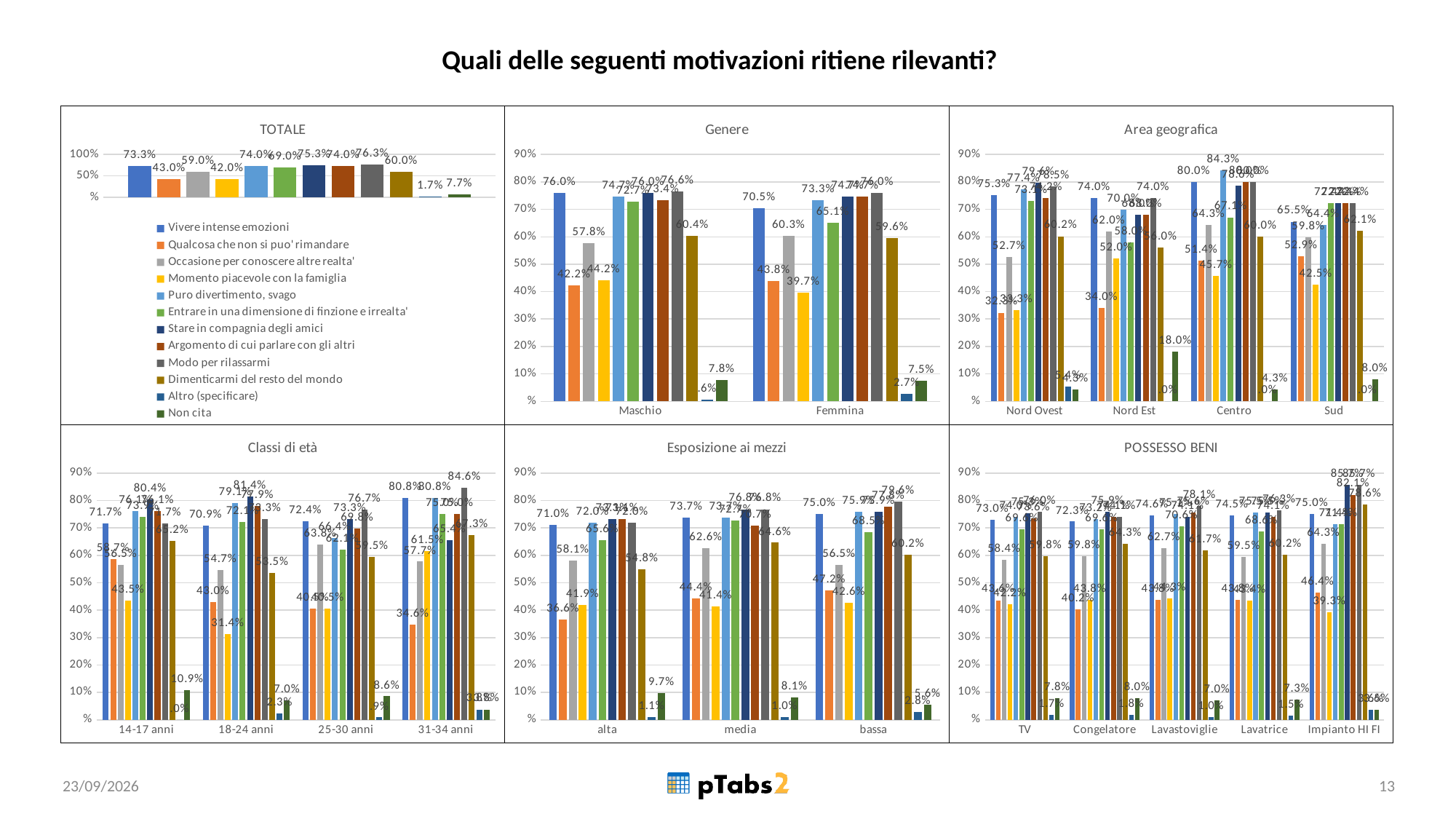
In the Genere chart, what is the value for 'Vivere intense emozioni' for Maschio? 76.0% In the Classi di età chart, what is the value for 'Momento piacevole con la famiglia' for 18-24 anni? 31.4% In the Area geografica chart, how many geographic categories are shown on the x axis? 4 In the Classi di età chart, is 'Non cita' for 14-17 anni (10.9%) larger or smaller than for 18-24 anni (7.0%)? larger In the TOTALE chart, what is the value for 'Vivere intense emozioni'? 73.3% What kind of chart is the POSSESSO BENI chart? bar chart How many series does the legend of the TOTALE chart list? 12 In the Esposizione ai mezzi chart, what is the value for 'Qualcosa che non si puo' rimandare' for alta? 36.6% In the Genere chart, what is the difference between 'Occasione per conoscere altre realta'' for Femmina (60.3%) and for Maschio (57.8%)? 2.5% In the TOTALE chart, which motivation has the highest value? Modo per rilassarmi In the Area geografica chart, what is the value for 'Puro divertimento, svago' for Centro? 84.3% In the TOTALE chart, what is the value for 'Altro (specificare)'? 1.7%